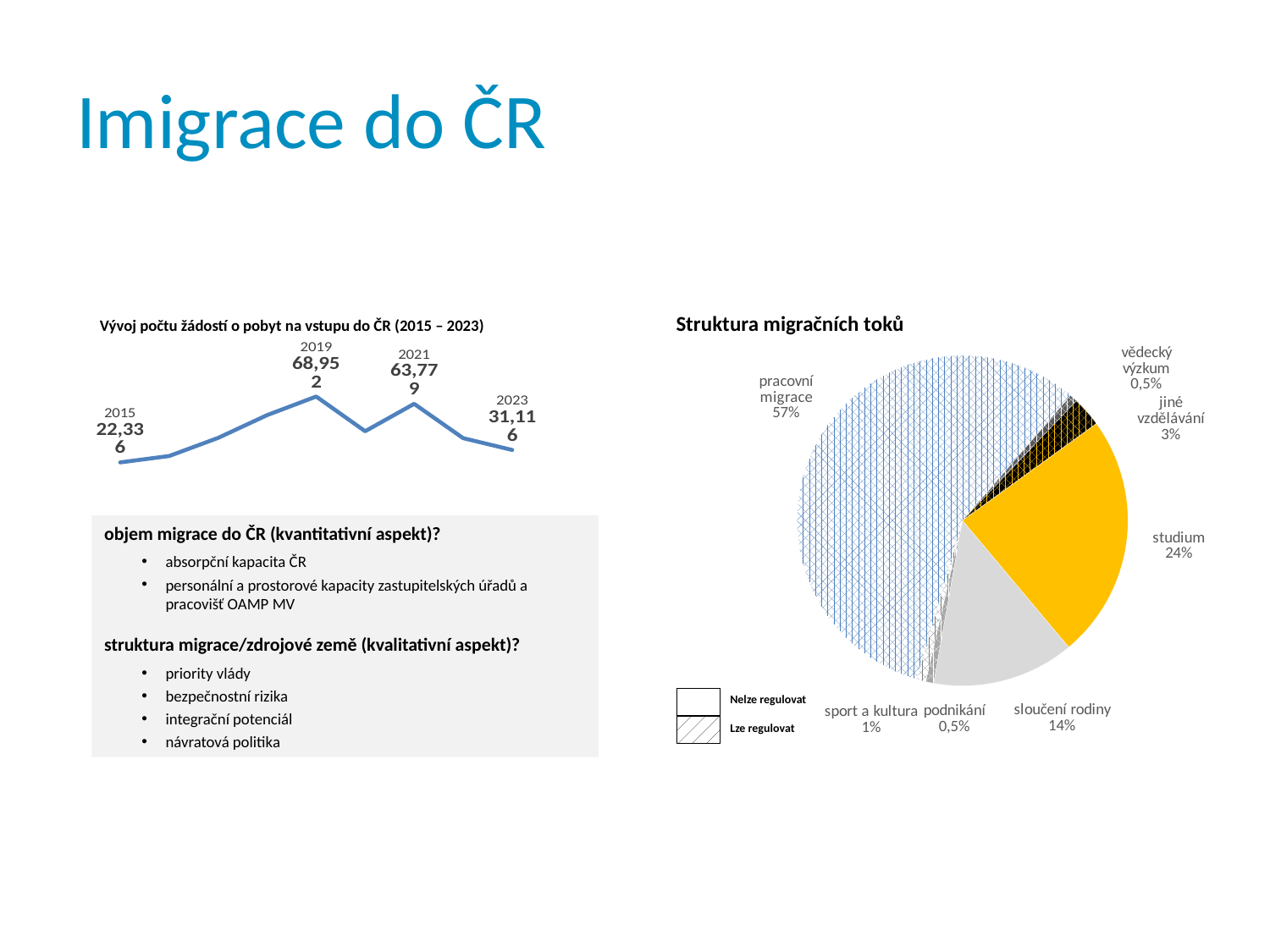
On the chart 'Vývoj počtu žádostí o pobyt na vstupu do ČR (2015 – 2023)', what is the value for 2023? 31,116 On the chart 'Vývoj počtu žádostí o pobyt na vstupu do ČR (2015 – 2023)', what is the difference between the values for 2019 and 2021? 5,173 How many slices does the pie chart 'Struktura migračních toků' have? 7 On the pie chart 'Struktura migračních toků', what share does 'sloučení rodiny' have? 14% What kind of chart is 'Vývoj počtu žádostí o pobyt na vstupu do ČR (2015 – 2023)'? line chart On the chart 'Vývoj počtu žádostí o pobyt na vstupu do ČR (2015 – 2023)', which labelled year has the highest value? 2019 On the chart 'Vývoj počtu žádostí o pobyt na vstupu do ČR (2015 – 2023)', what is the value for 2015? 22,336 On the chart 'Vývoj počtu žádostí o pobyt na vstupu do ČR (2015 – 2023)', which labelled year has the lowest value? 2015 On the chart 'Vývoj počtu žádostí o pobyt na vstupu do ČR (2015 – 2023)', which is larger, the value for 2021 or the value for 2023? 2021 On the pie chart 'Struktura migračních toků', which category has the largest share? pracovní migrace On the pie chart 'Struktura migračních toků', what share does 'pracovní migrace' have? 57% On the chart 'Vývoj počtu žádostí o pobyt na vstupu do ČR (2015 – 2023)', what is the value for 2019? 68,952